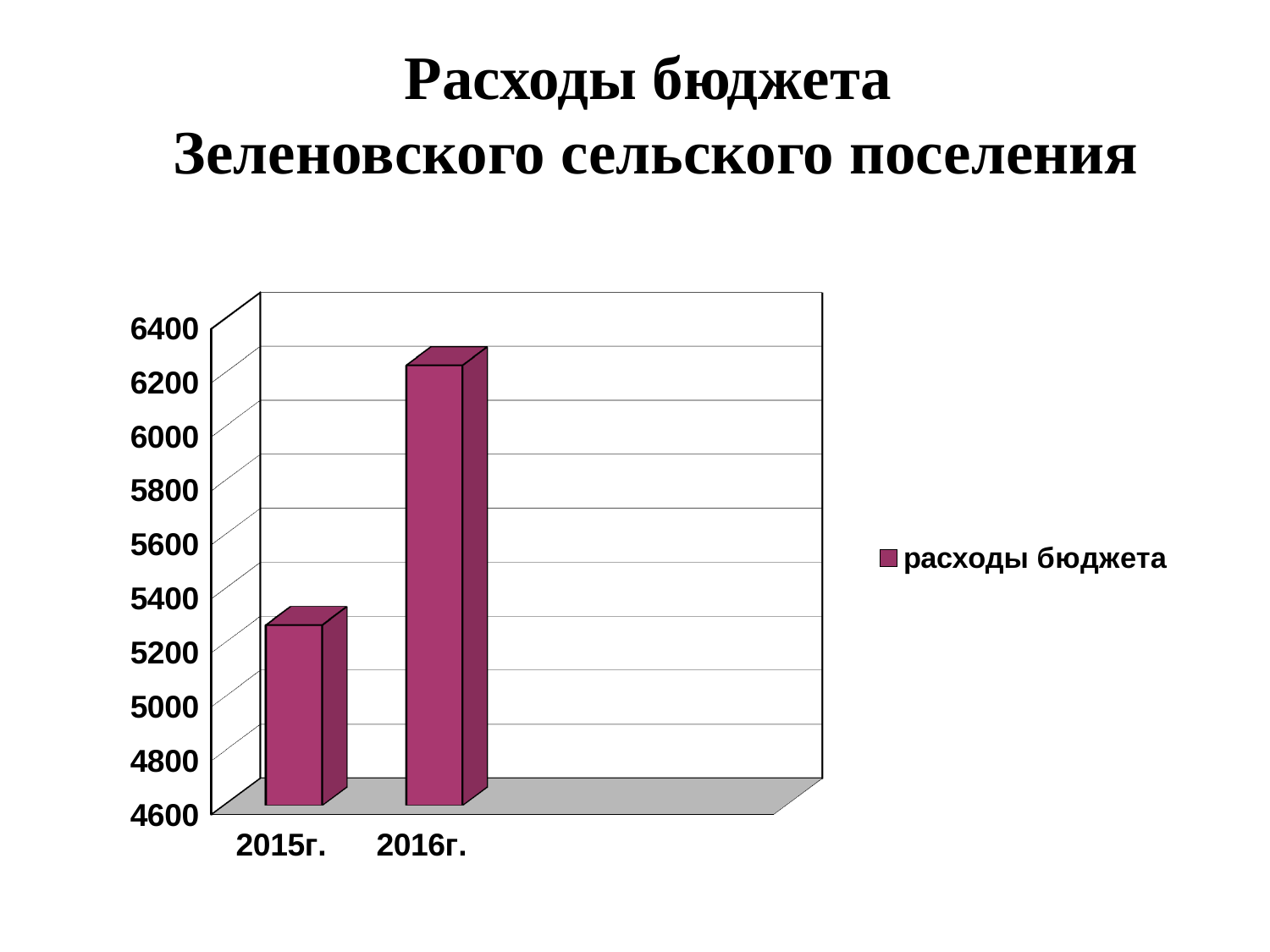
Do the values rise or fall from 2015г. to 2016г.? rise Is the value for 2016г. greater or less than 6000? greater What kind of chart is shown on the slide? bar chart What is the name of the series shown in the chart's legend? расходы бюджета Is the value for 2016г. larger or smaller than the value for 2015г.? larger Is the value for 2015г. greater or less than 5600? less How many series does the chart's legend list? 1 Is the value for 2016г. greater or less than 6400? less Which year has the lower budget expenditure in the chart? 2015г. Which year has the higher budget expenditure in the chart? 2016г. How many categories are shown on the x axis of the chart? 2